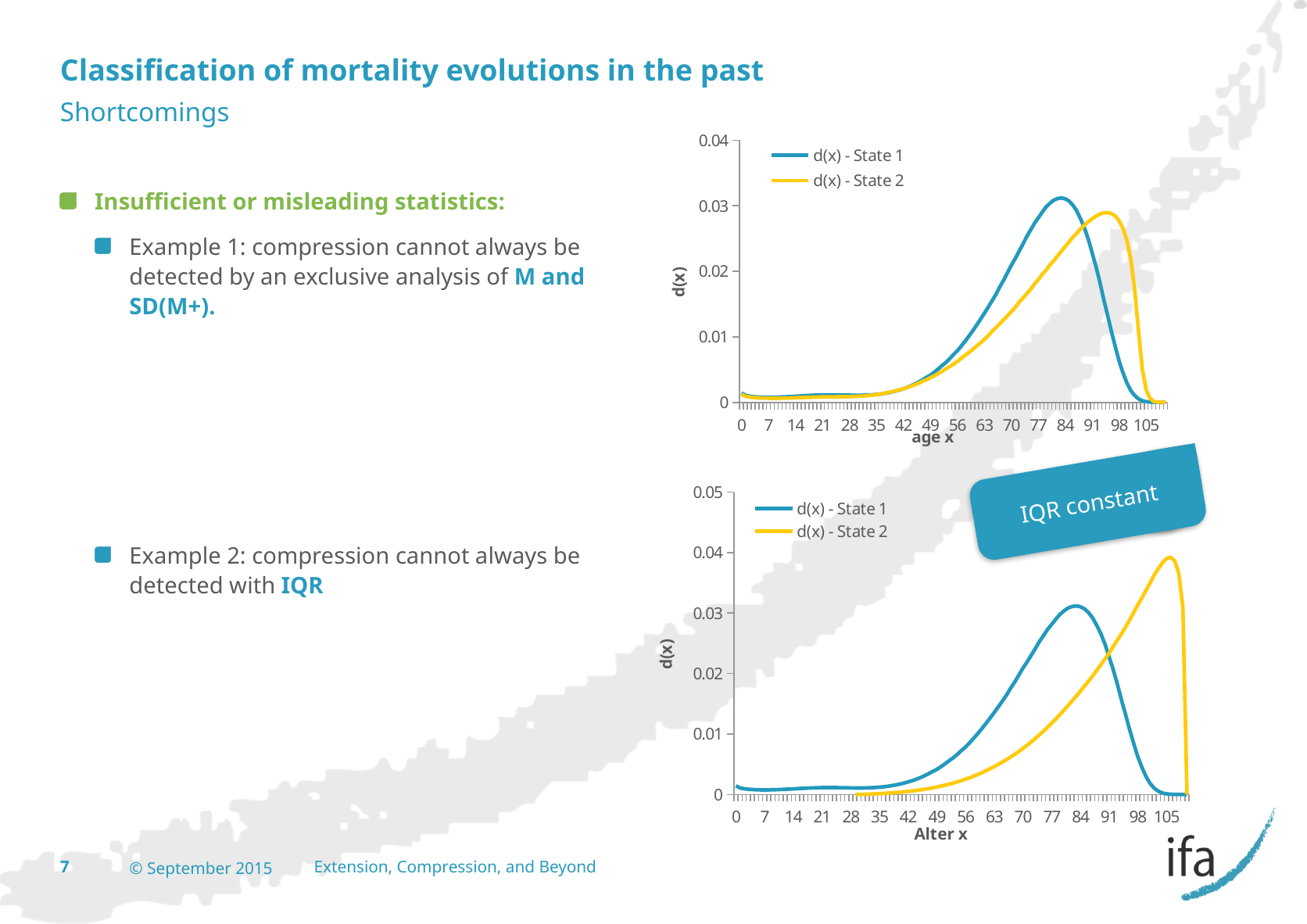
What is the x-axis title of the bottom chart? Alter x In the top chart, is the value of d(x) - State 1 at age 49 greater or less than 0.01? less What is the highest value shown on the y-axis of the bottom chart? 0.05 In the bottom chart, is the value of d(x) - State 2 at age 105 greater or less than 0.03? greater What are the two legend entries in the bottom chart? d(x) - State 1 and d(x) - State 2 In the bottom chart, does d(x) - State 1 rise or fall between age 84 and age 105? fall In the bottom chart, is the value of d(x) - State 1 at age 105 greater or less than 0.01? less What kind of chart is the top chart on the slide? line chart How many series does the legend of the top chart list? 2 In the bottom chart, which series reaches the higher peak, State 1 or State 2? d(x) - State 2 In the top chart, does d(x) - State 2 rise or fall between age 49 and age 91? rise